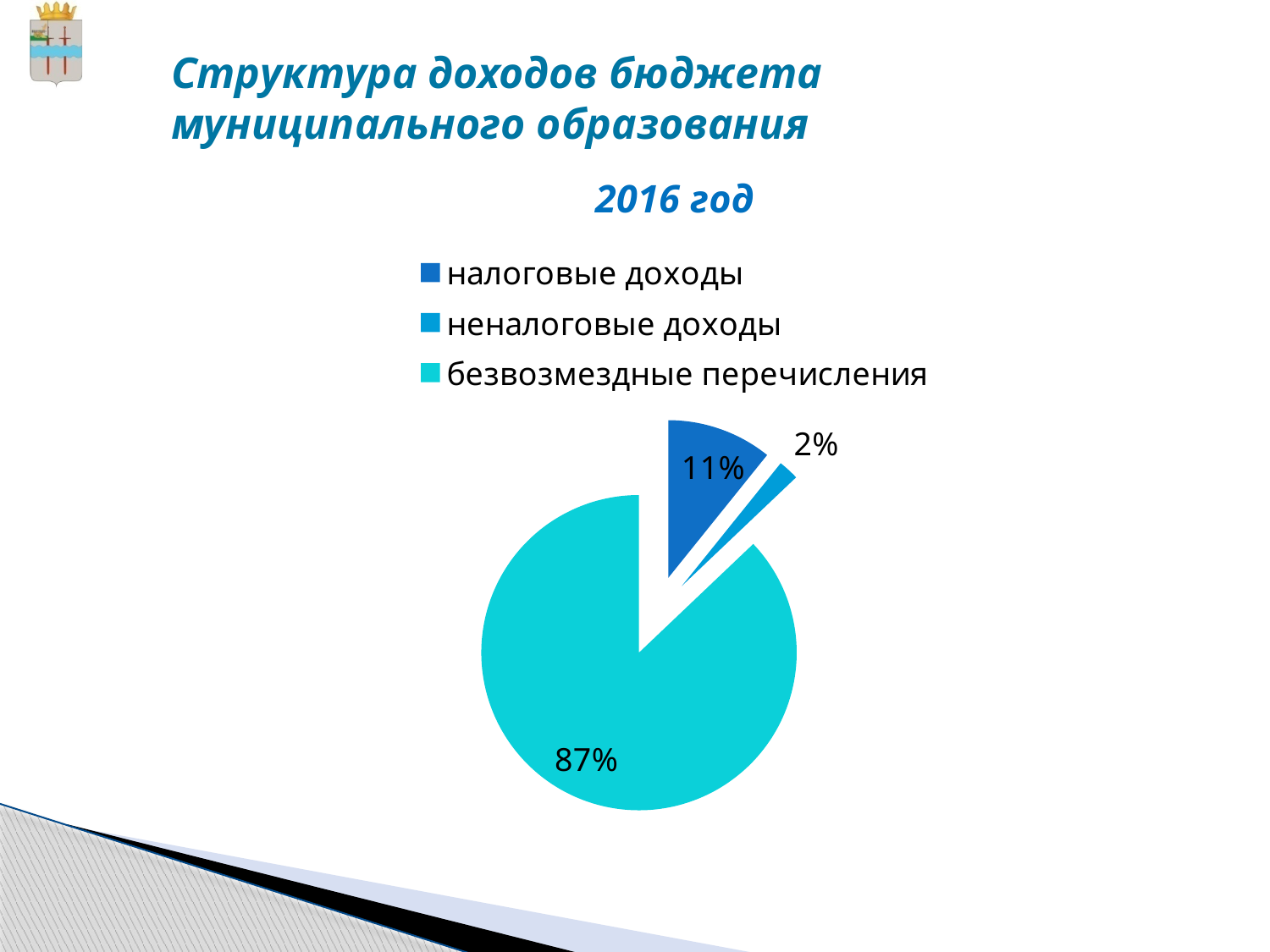
How many entries does the legend list? 3 What kind of chart is shown on the slide? pie chart What share of the pie does безвозмездные перечисления have? 87% Which is larger, the share for налоговые доходы or the share for неналоговые доходы? налоговые доходы Which category has the smallest slice of the pie? неналоговые доходы Which category has the largest slice of the pie? безвозмездные перечисления What is the difference in percentage points between безвозмездные перечисления and налоговые доходы? 76 What share of the pie does налоговые доходы have? 11% How many slices does the pie chart have? 3 What share of the pie does неналоговые доходы have? 2% What is the difference in percentage points between налоговые доходы and неналоговые доходы? 9 What year is shown as the chart title? 2016 год